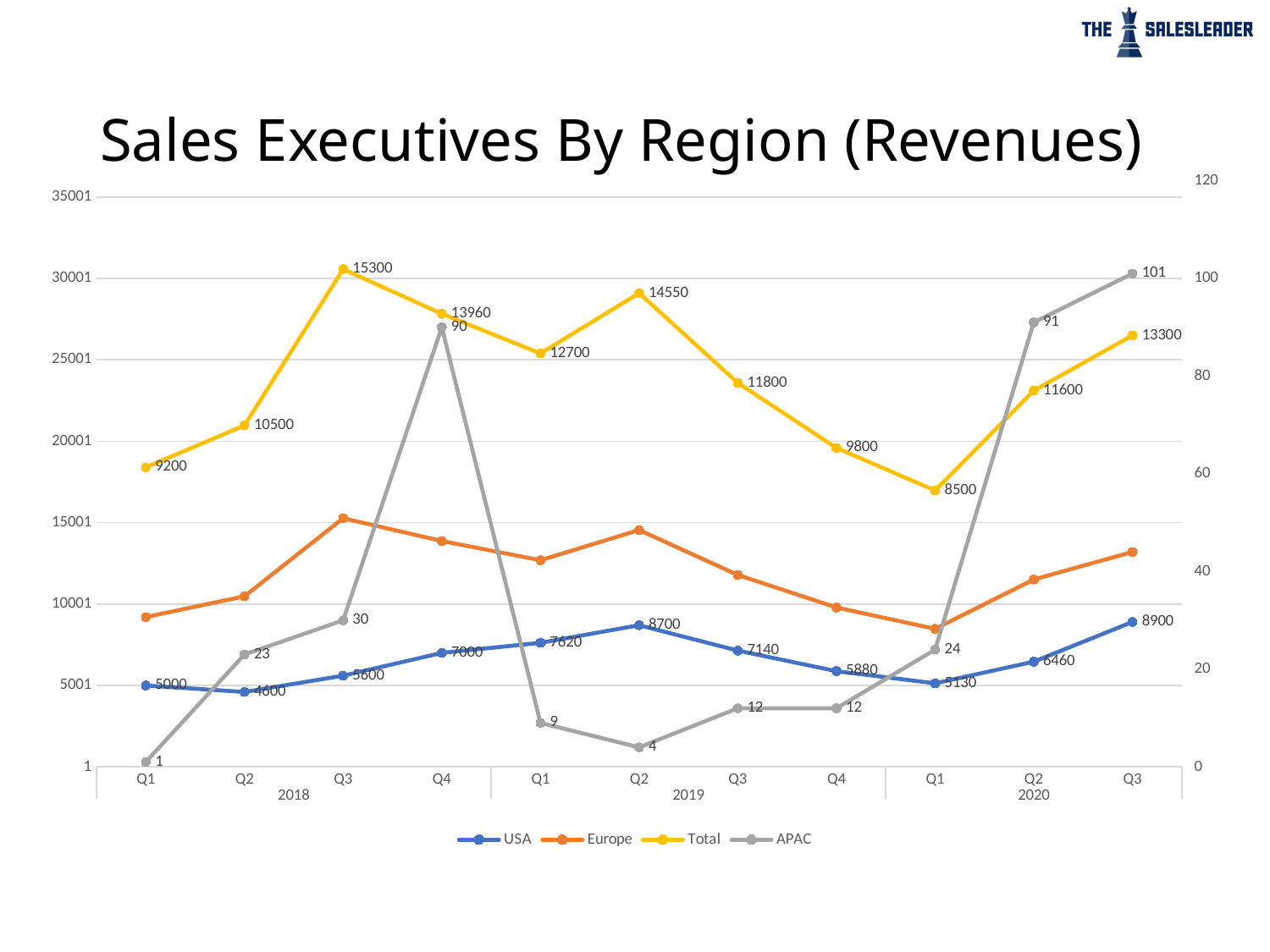
How many quarters are plotted along the x axis? 11 How many series does the legend list? 4 What is the APAC value for Q3 2020? 101 In which quarter is the APAC value lowest? Q1 2018 What is the Total value for Q3 2018? 15300 What is the difference between the USA value in Q3 2020 and in Q1 2018? 3900 What kind of chart is shown on the slide? line chart Which is larger, the Total value for Q2 2019 or for Q4 2018? Q2 2019 In which quarter is the USA value highest? Q3 2020 In which quarter is the Total value lowest? Q1 2020 What is the USA value for Q2 2019? 8700 What is the title of the chart? Sales Executives By Region (Revenues)